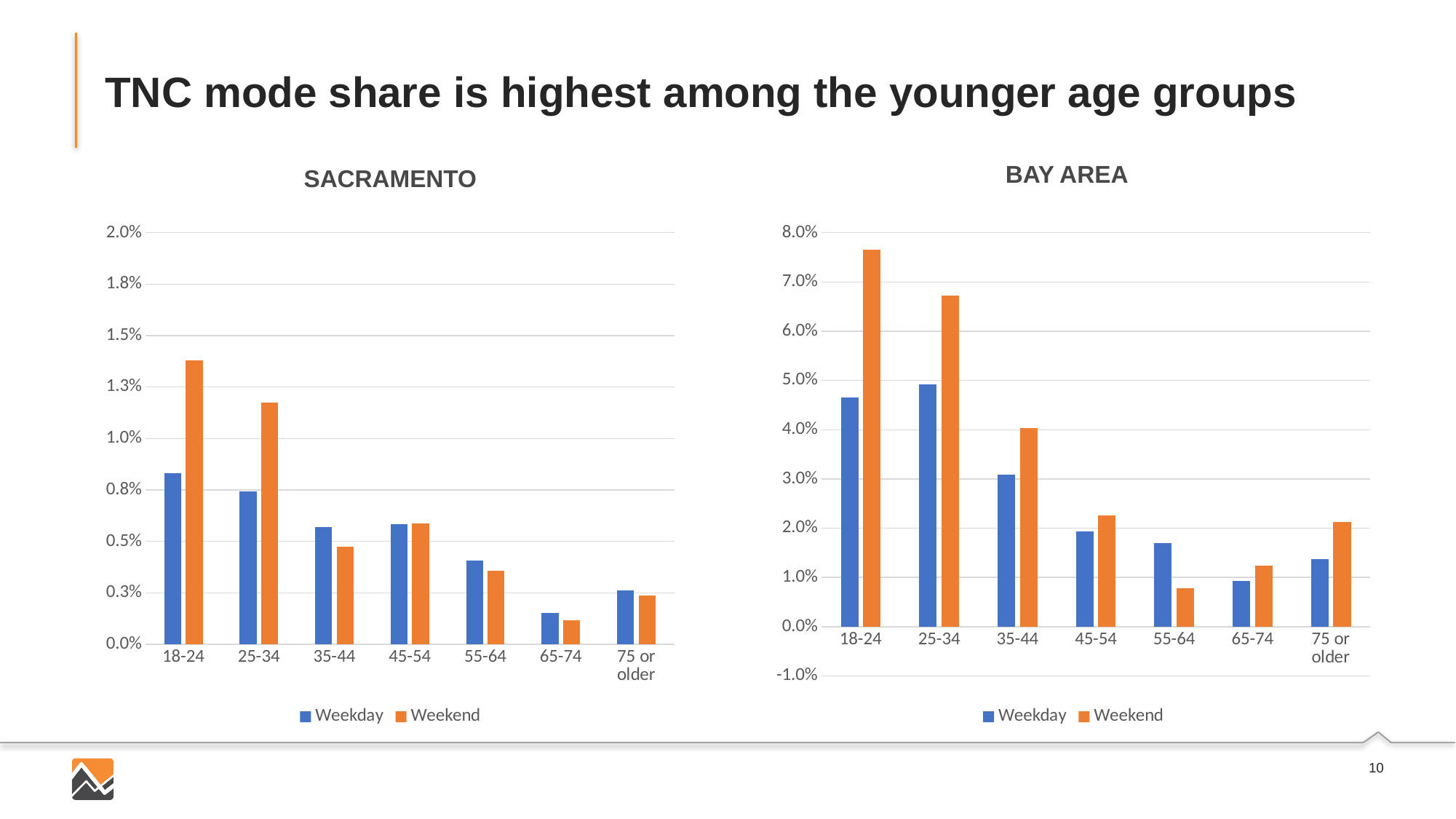
On the SACRAMENTO chart, which age group has the highest Weekend value? 18-24 On the BAY AREA chart, which age group has the highest Weekend value? 18-24 On the SACRAMENTO chart, do the Weekday values generally rise or fall from the 18-24 group to the 65-74 group? fall On the BAY AREA chart, is the Weekday value for 18-24 greater or less than 5.0%? less On the BAY AREA chart, which age group has the lowest Weekday value? 65-74 On the BAY AREA chart, which is larger for the 35-44 age group, the Weekday or the Weekend value? Weekend How many series does the legend of the SACRAMENTO chart list? 2 On the SACRAMENTO chart, which age group has the lowest Weekday value? 65-74 On the BAY AREA chart, is the Weekend value for 18-24 greater or less than 7.0%? greater What kind of chart is the SACRAMENTO chart? bar chart How many age groups are shown on the BAY AREA chart? 7 On the SACRAMENTO chart, is the Weekday value for 18-24 greater or less than 0.8%? greater